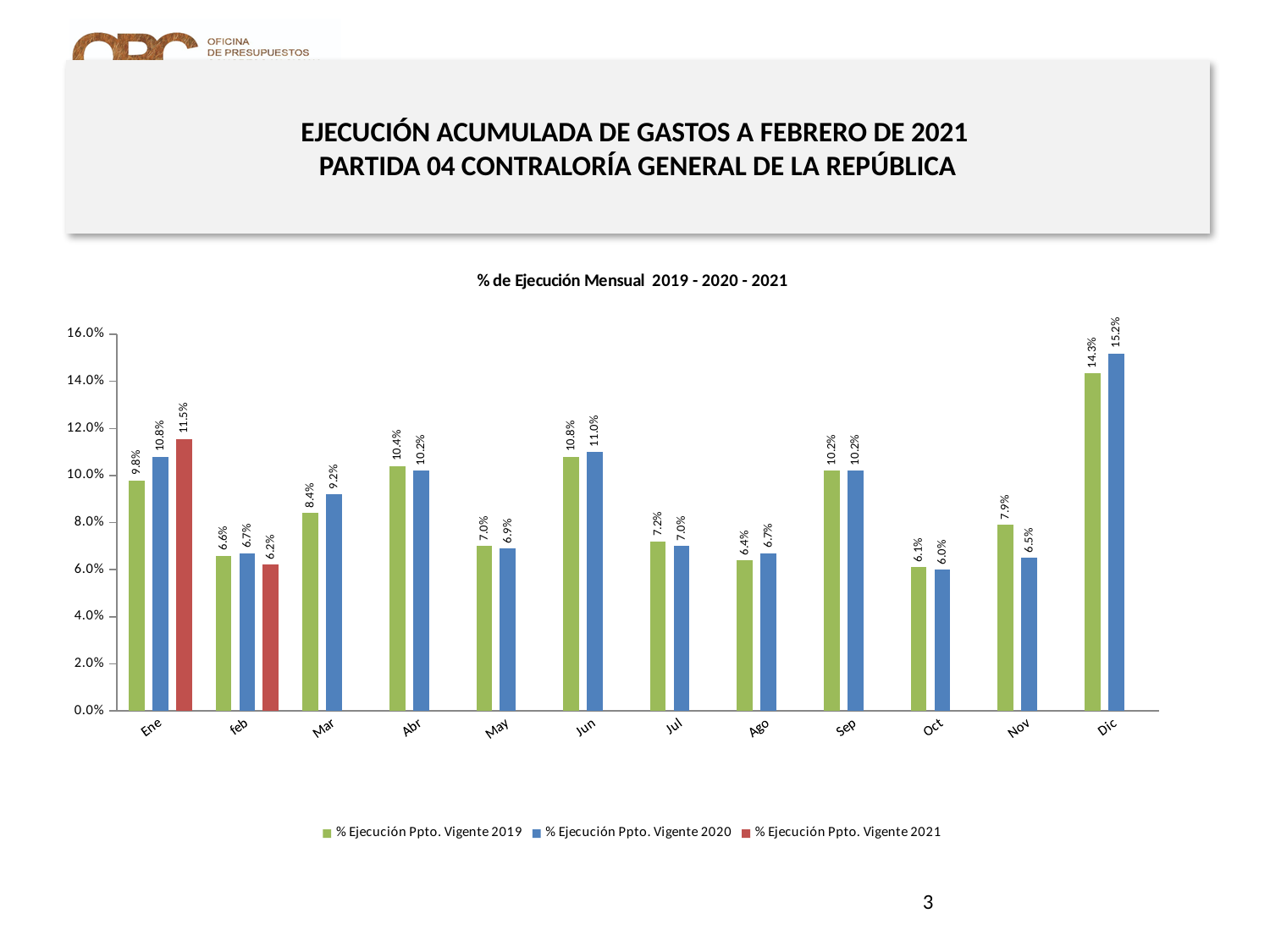
How many months are shown on the x axis? 12 Which is larger for Nov: the 2019 value or the 2020 value? 2019 Which month has the highest value in the % Ejecución Ppto. Vigente 2019 series? Dic Which colour represents the % Ejecución Ppto. Vigente 2021 series? Red Is the value for Dic in the 2020 series greater or less than 14.0%? greater What is the value for Ene in the % Ejecución Ppto. Vigente 2021 series? 11.5% What is the value for Dic in the % Ejecución Ppto. Vigente 2020 series? 15.2% How many series does the legend list? 3 Which month has the lowest value in the % Ejecución Ppto. Vigente 2020 series? Oct What kind of chart is shown? Bar chart What is the difference between the 2020 and 2019 values for Dic? 0.9% What is the value for Nov in the % Ejecución Ppto. Vigente 2019 series? 7.9%